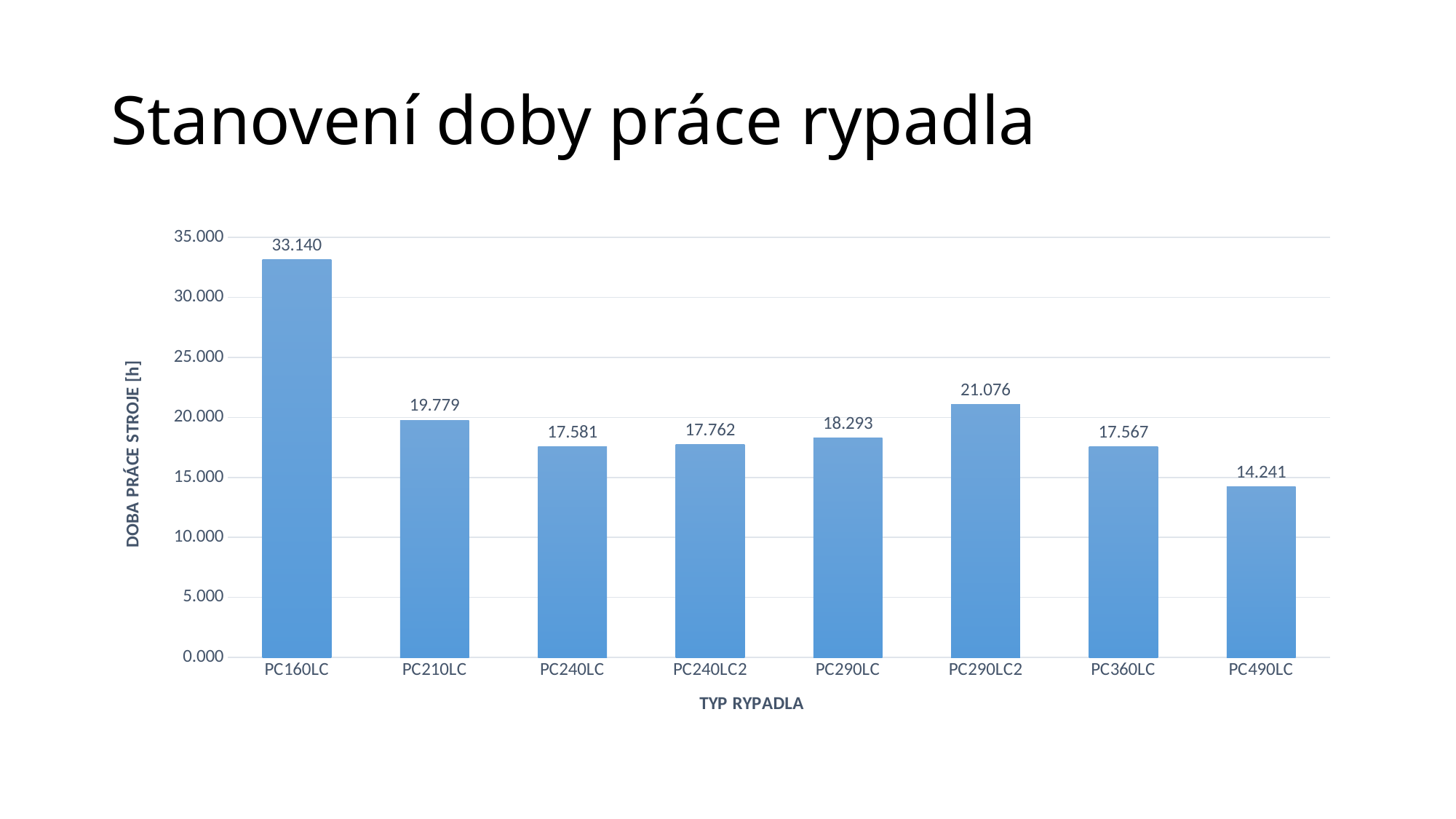
How many excavator types are shown on the x axis? 8 What is the value for PC160LC? 33.140 Which excavator type has the lowest value? PC490LC What is the difference between the values for PC290LC2 and PC210LC? 1.297 What is the value for PC490LC? 14.241 What is the difference between the values for PC160LC and PC490LC? 18.899 What kind of chart is shown on the slide? bar chart Which has a larger value, PC290LC2 or PC210LC? PC290LC2 What is the label of the y axis? DOBA PRÁCE STROJE [h] What is the value for PC290LC2? 21.076 Which excavator type has the highest value? PC160LC Is the value for PC490LC greater or less than 15.000? less